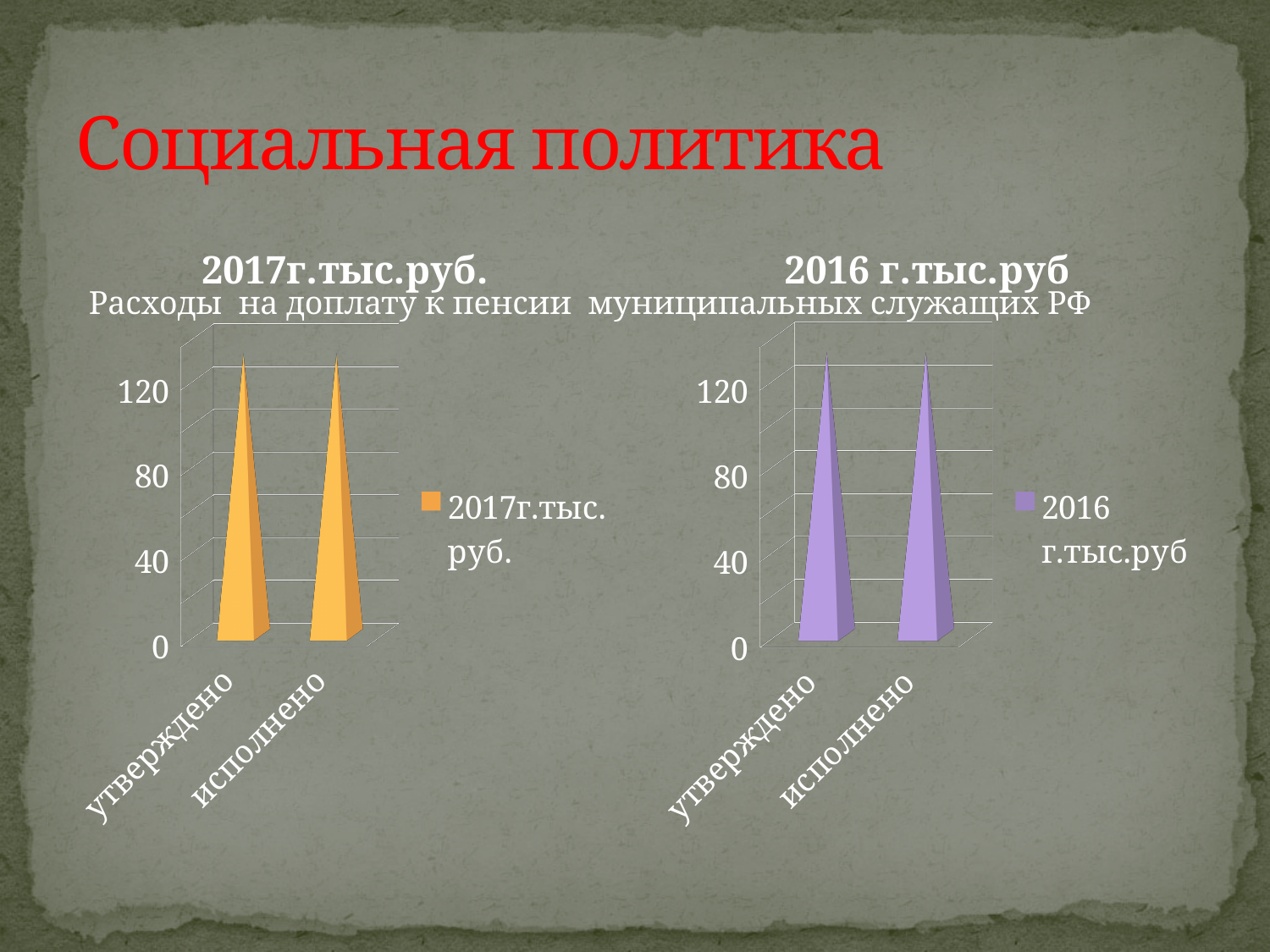
In the left chart titled "2017г.тыс.руб.", is the value for утверждено greater or less than 120? greater What is the legend entry of the left chart titled "2017г.тыс.руб."? 2017г.тыс.руб. What kind of chart is the left chart titled "2017г.тыс.руб."? bar chart In the left chart titled "2017г.тыс.руб.", how many categories are shown on the x axis? 2 In the right chart titled "2016 г.тыс.руб", is the value for утверждено greater or less than 120? greater What colour are the bars in the right chart titled "2016 г.тыс.руб"? purple What kind of chart is the right chart titled "2016 г.тыс.руб"? bar chart In the right chart titled "2016 г.тыс.руб", how many categories are shown on the x axis? 2 In the left chart titled "2017г.тыс.руб.", is the value for исполнено greater or less than 80? greater In the right chart titled "2016 г.тыс.руб", how many series does the legend list? 1 In the left chart titled "2017г.тыс.руб.", how many series does the legend list? 1